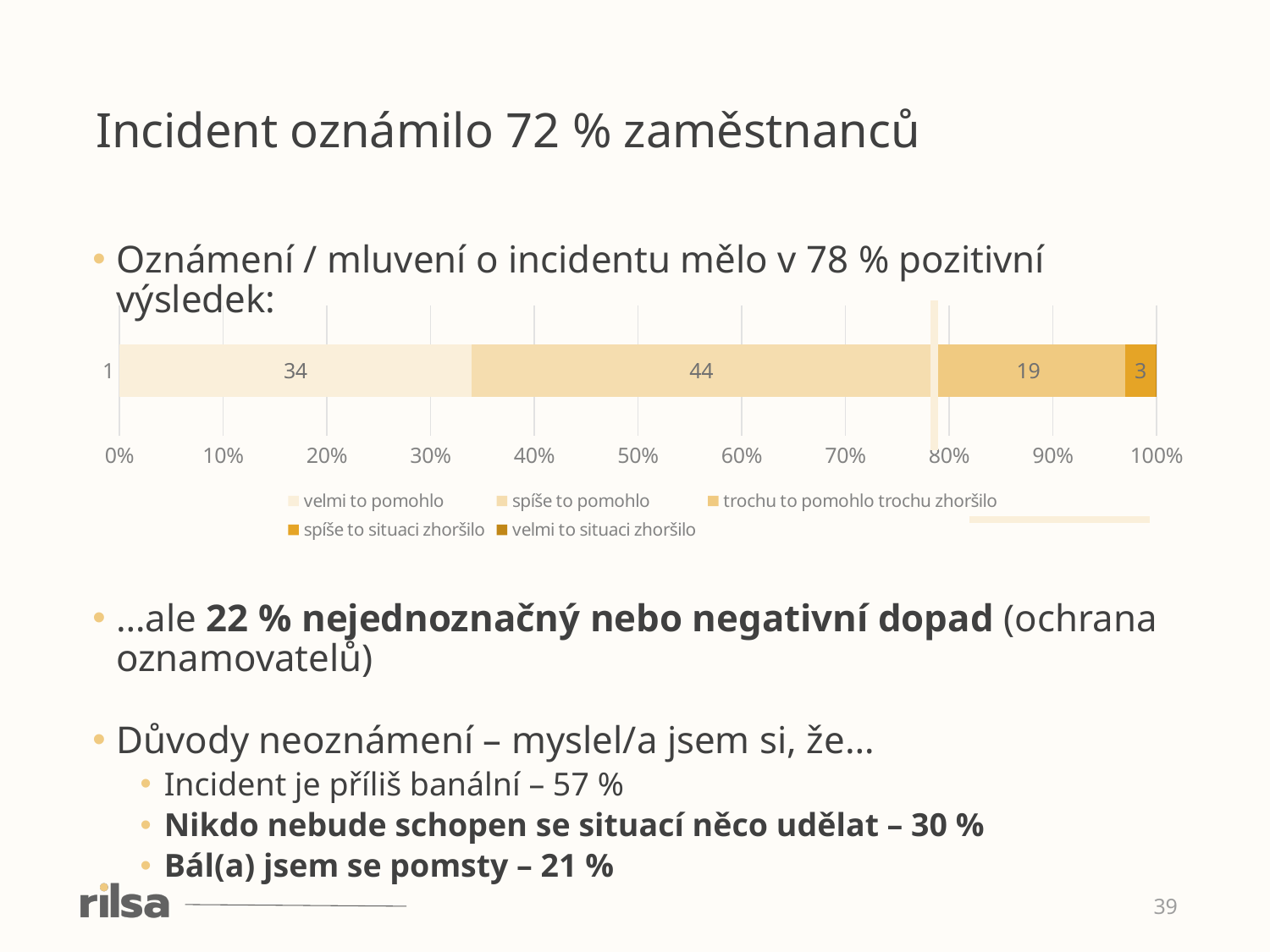
What kind of chart is shown on the slide? stacked bar chart Which is larger: 'trochu to pomohlo trochu zhoršilo' or 'spíše to situaci zhoršilo'? trochu to pomohlo trochu zhoršilo What value is shown for the 'spíše to pomohlo' segment of the stacked bar? 44 How many series does the chart legend list? 5 What is the combined value of the 'velmi to pomohlo' and 'spíše to pomohlo' segments? 78 What is the last entry listed in the chart legend? velmi to situaci zhoršilo Which labelled segment of the stacked bar has the largest value? spíše to pomohlo What value is shown for the 'spíše to situaci zhoršilo' segment? 3 Which labelled segment of the stacked bar has the smallest value? spíše to situaci zhoršilo What value is shown for the 'trochu to pomohlo trochu zhoršilo' segment? 19 What is the difference between the 'spíše to pomohlo' and 'velmi to pomohlo' values? 10 What value is shown for the 'velmi to pomohlo' segment of the stacked bar? 34